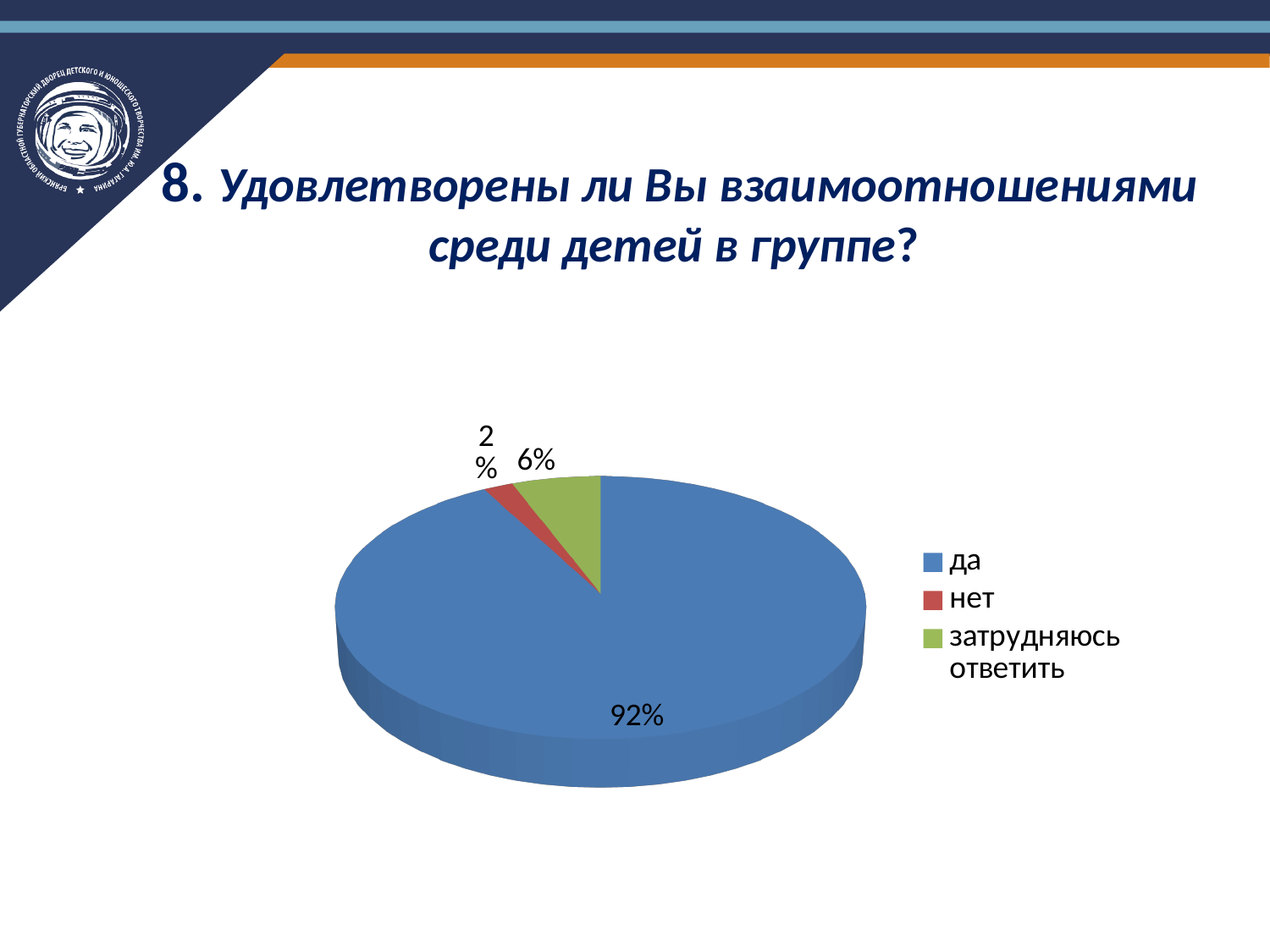
Which category has the largest slice of the pie? да What is the difference between the shares for "да" and "затрудняюсь ответить"? 86% What kind of chart is shown on the slide? pie chart What share of the pie does "затрудняюсь ответить" take? 6% Which category has the smallest slice of the pie? нет What colour is the slice for "да"? blue How many categories does the pie chart have? 3 Which is larger, the share for "нет" or the share for "затрудняюсь ответить"? затрудняюсь ответить What is the difference between the shares for "затрудняюсь ответить" and "нет"? 4% What share of the pie does "нет" take? 2% What colour is the slice for "нет"? red What share of the pie does "да" take? 92%